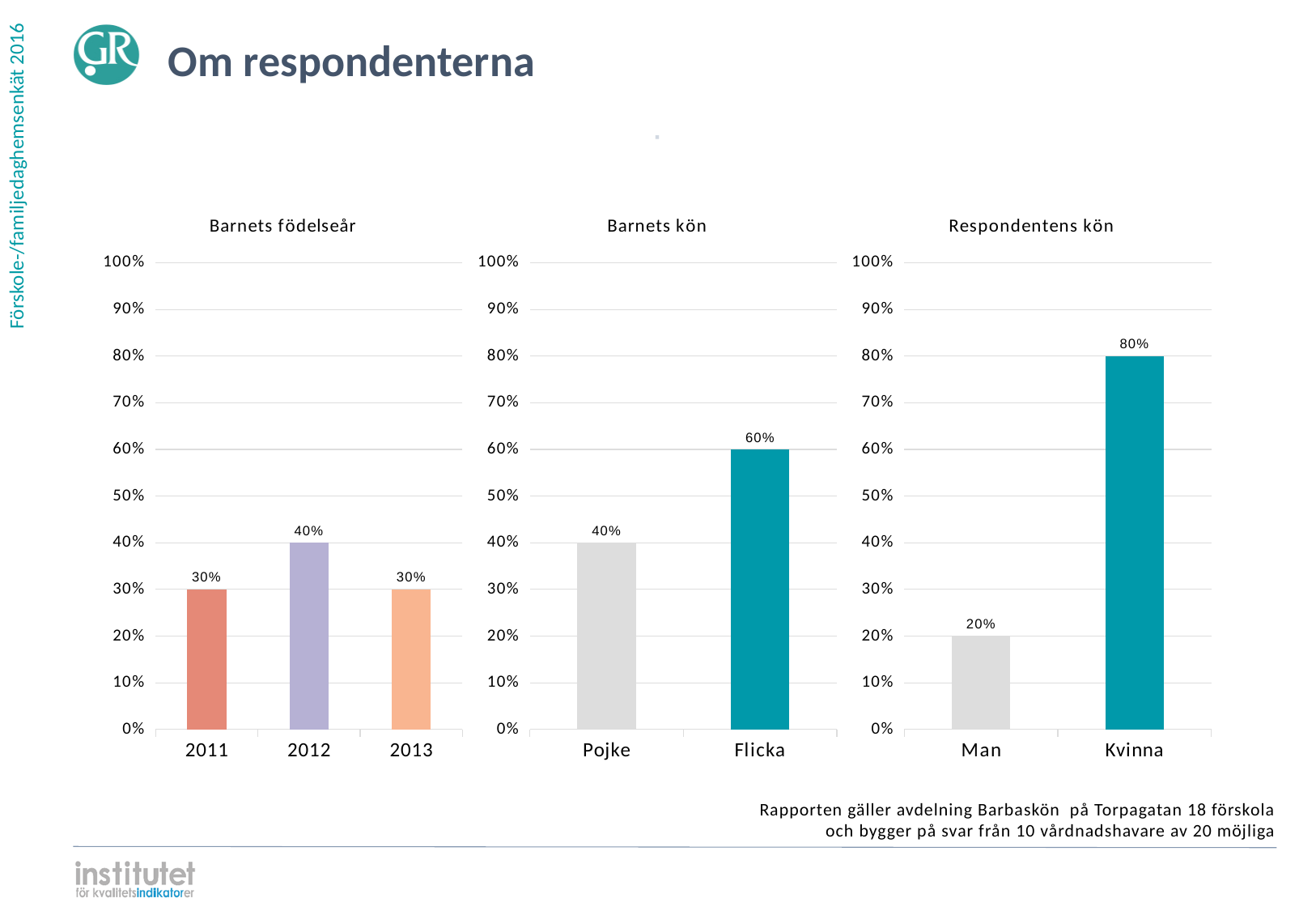
In the 'Barnets födelseår' chart, how many categories are shown on the x axis? 3 In the 'Barnets födelseår' chart, what is the value for 2012? 40% In the 'Barnets födelseår' chart, which year has the highest value? 2012 In the 'Respondentens kön' chart, what is the difference between the values for Kvinna and Man? 60% In the 'Barnets födelseår' chart, what is the difference between the values for 2012 and 2011? 10% In the 'Barnets kön' chart, what is the value for Flicka? 60% In the 'Respondentens kön' chart, what is the value for Man? 20% What is the title of the leftmost chart on the slide? Barnets födelseår In the 'Barnets kön' chart, which category has the lowest value? Pojke In the 'Barnets kön' chart, what is the difference between the values for Flicka and Pojke? 20% In the 'Respondentens kön' chart, which is larger, the value for Man or the value for Kvinna? Kvinna What kind of chart is the 'Respondentens kön' chart? Bar chart